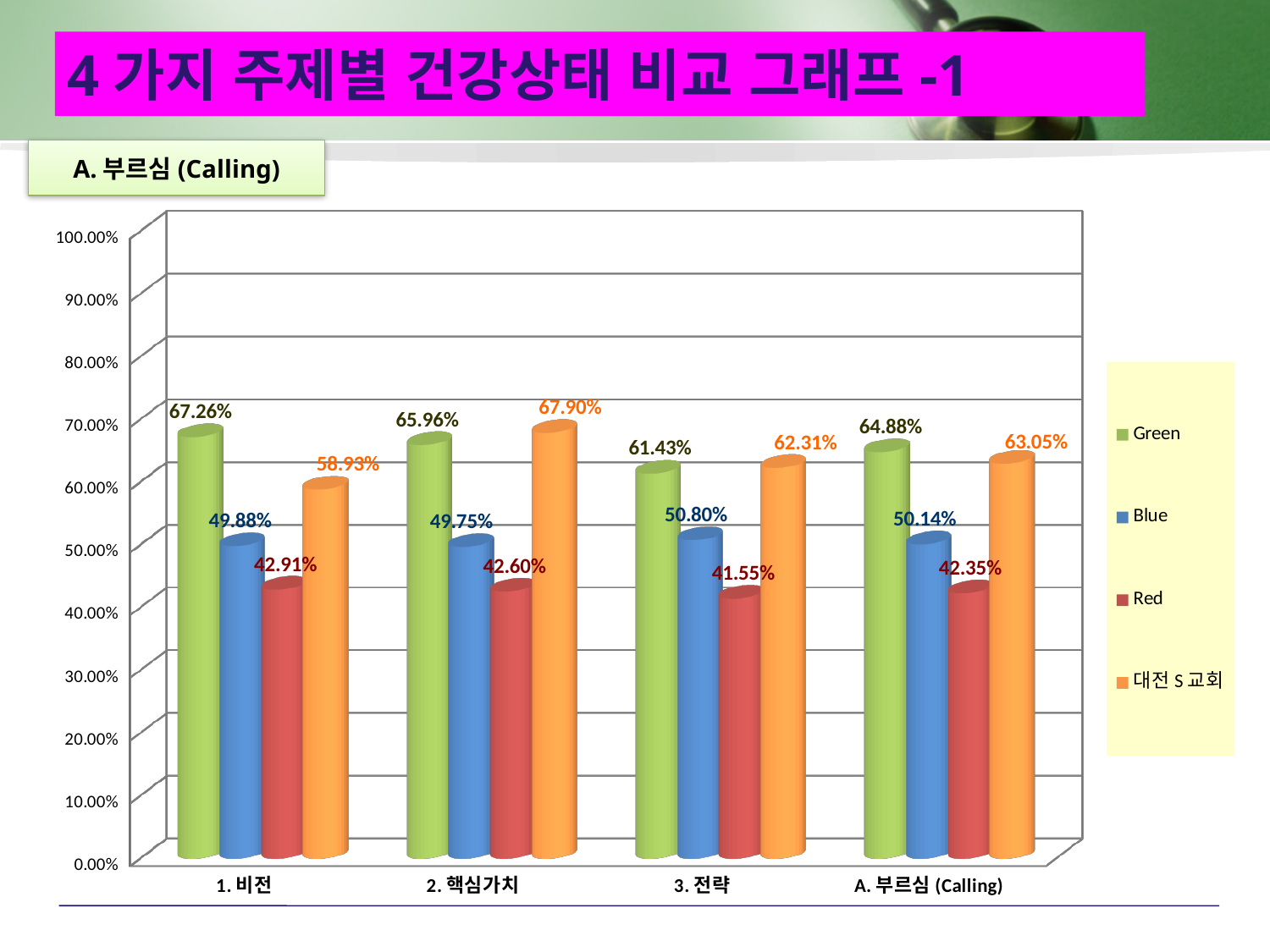
What is the difference between the Green and Red values in the 1. 비전 category? 24.35% In the 2. 핵심가치 category, which is larger: the Green value or the 대전 S 교회 value? 대전 S 교회 What is the value for Red in the 3. 전략 category? 41.55% Which category has the lowest value for 대전 S 교회? 1. 비전 Which series is shown in orange in the legend? 대전 S 교회 What kind of chart is shown on the slide? Bar chart What is the value for Blue in the A. 부르심 (Calling) category? 50.14% How many categories are shown on the x axis? 4 What is the value for Green in the 1. 비전 category? 67.26% How many series does the legend list? 4 What is the value for 대전 S 교회 in the 2. 핵심가치 category? 67.90% Which category has the highest value for Green? 1. 비전